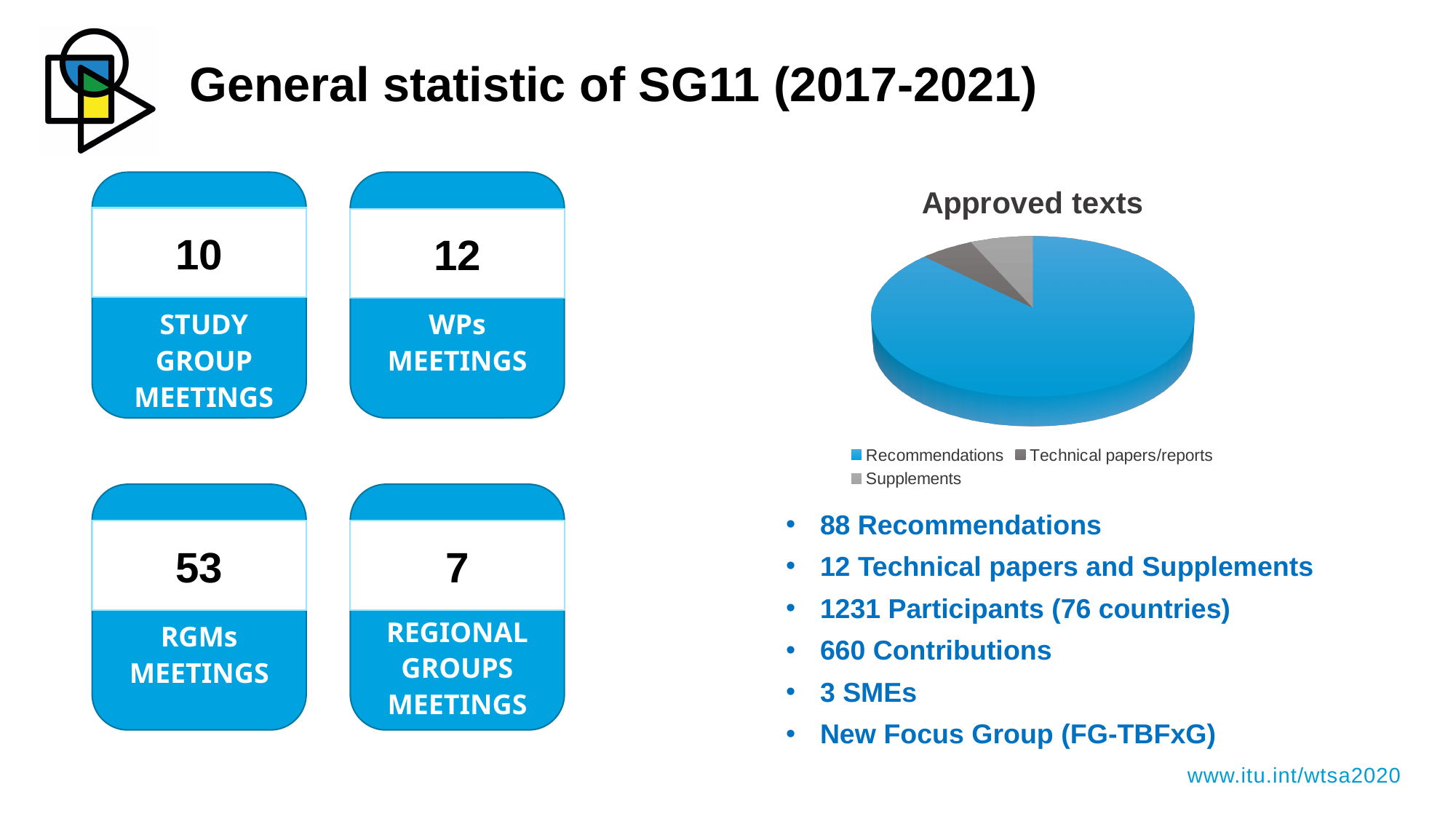
What kind of chart is shown under the title "Approved texts"? pie chart How many entries does the legend of the "Approved texts" pie chart list? 3 Which legend entry of the "Approved texts" pie chart is listed on the second line of the legend? Supplements What colour is the Recommendations slice in the "Approved texts" pie chart? blue In the "Approved texts" pie chart, is the Recommendations slice greater or less than half of the pie? greater Which category takes up the largest slice of the "Approved texts" pie chart? Recommendations In the "Approved texts" pie chart, which slice is larger: Recommendations or Technical papers/reports? Recommendations What is the title of the pie chart on the slide? Approved texts How many slices does the "Approved texts" pie chart have? 3 In the "Approved texts" pie chart, which slice is larger: Recommendations or Supplements? Recommendations